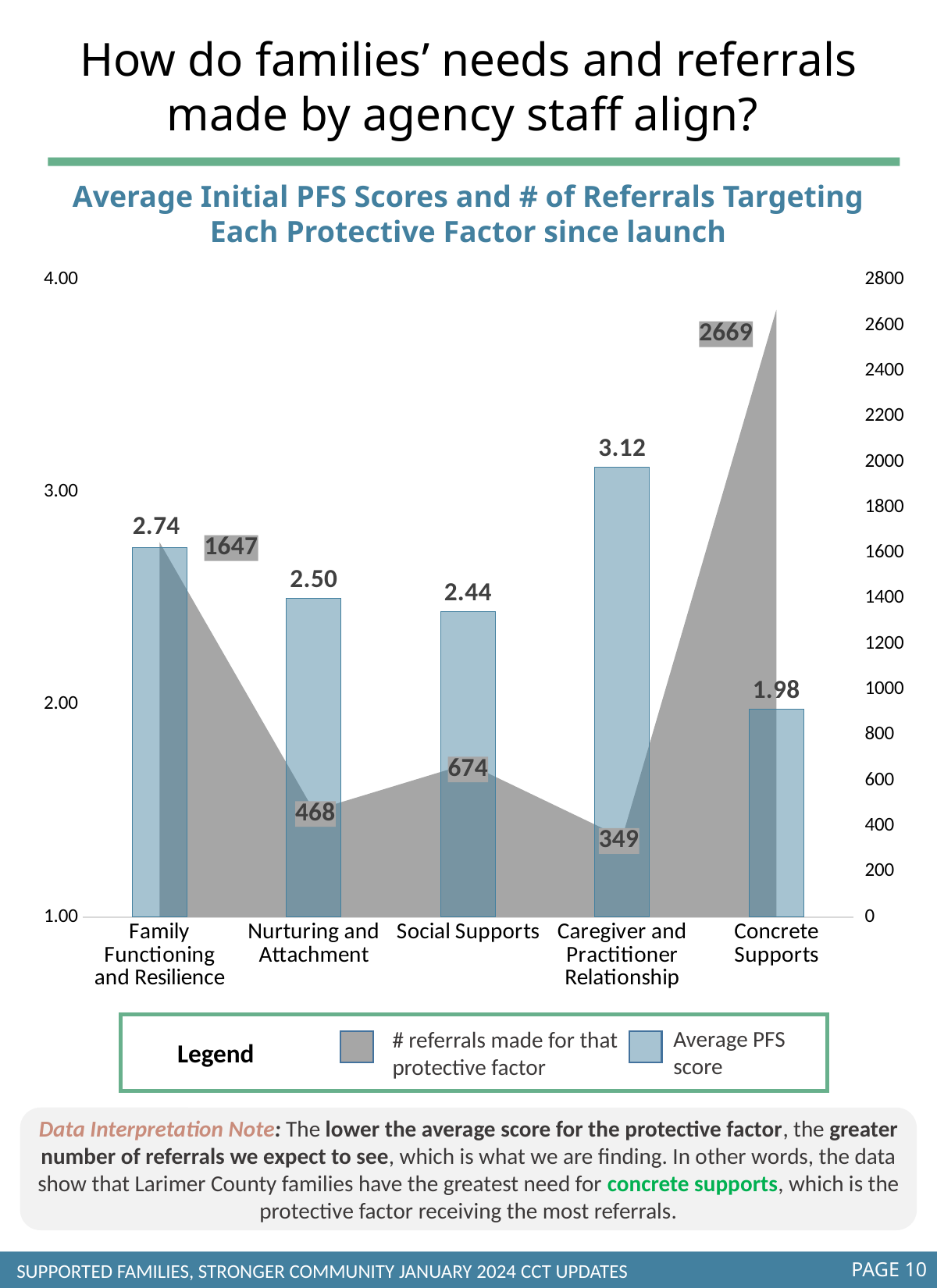
Which has more referrals, Social Supports or Nurturing and Attachment? Social Supports How many referrals were made for Concrete Supports? 2669 What is the difference between the average PFS scores for Family Functioning and Resilience and Concrete Supports? 0.76 Which protective factor received the fewest referrals? Caregiver and Practitioner Relationship What is the difference in number of referrals between Concrete Supports and Family Functioning and Resilience? 1022 How many protective factors are shown on the x axis? 5 How many series does the legend list? 2 Which protective factor has the highest average PFS score? Caregiver and Practitioner Relationship What is the average PFS score for Caregiver and Practitioner Relationship? 3.12 How many referrals were made for Nurturing and Attachment? 468 Which protective factor has the lowest average PFS score? Concrete Supports What is the title of the chart? Average Initial PFS Scores and # of Referrals Targeting Each Protective Factor since launch